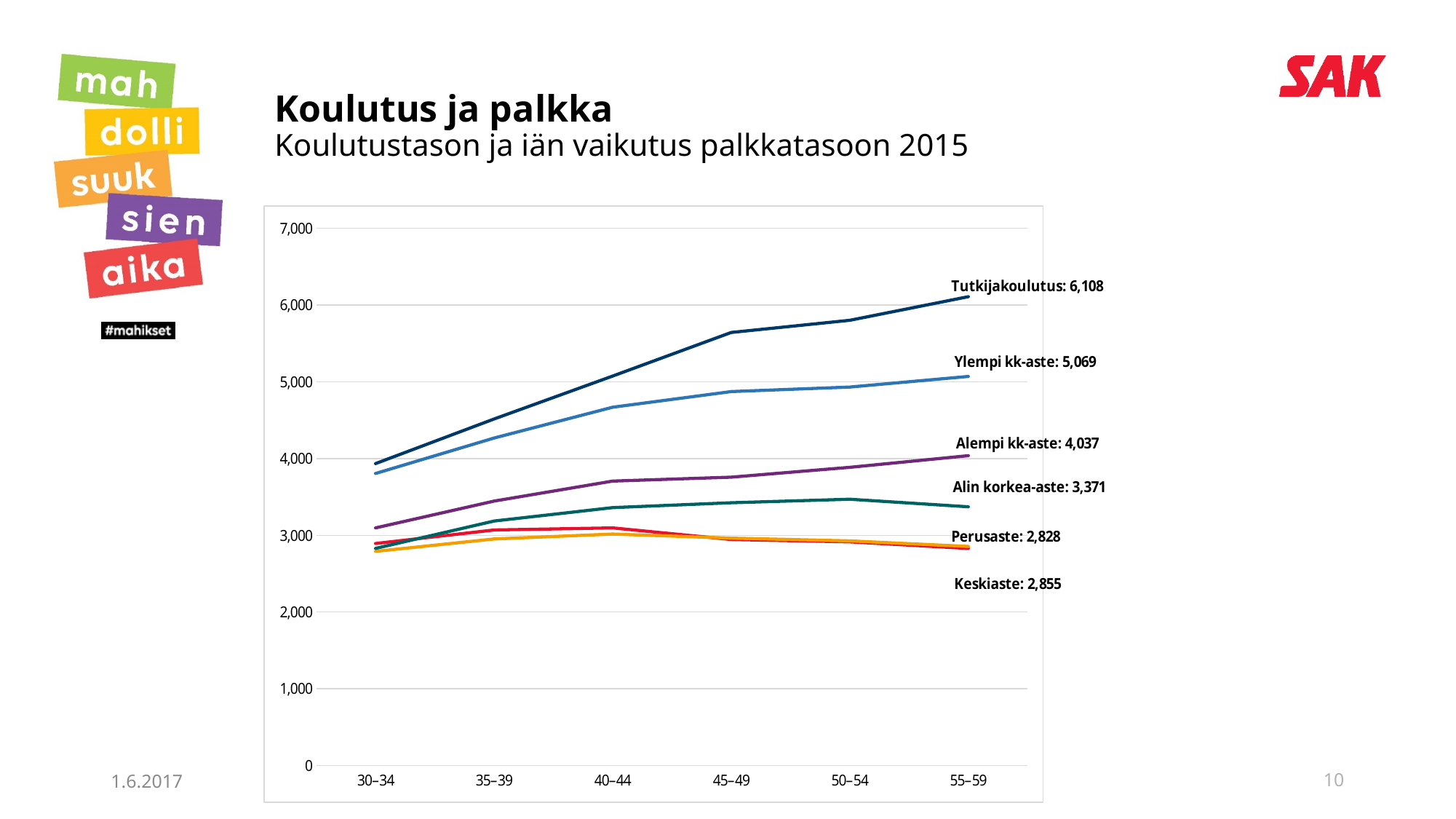
Is the value for Alempi kk-aste in the 30–34 age group greater or less than 4,000? less What value is labelled for Alempi kk-aste? 4,037 What kind of chart is shown on the slide? Line chart What value is labelled for Tutkijakoulutus at the end of its line? 6,108 Which education level has the lowest labelled value? Perusaste Which has the larger labelled value, Keskiaste or Perusaste? Keskiaste How many age groups are shown on the x axis? 6 What is the difference between the labelled values for Tutkijakoulutus and Ylempi kk-aste? 1,039 Which education level has the highest labelled value? Tutkijakoulutus What value is labelled for Perusaste? 2,828 What value is labelled for Ylempi kk-aste at the end of its line? 5,069 What value is labelled for Alin korkea-aste? 3,371